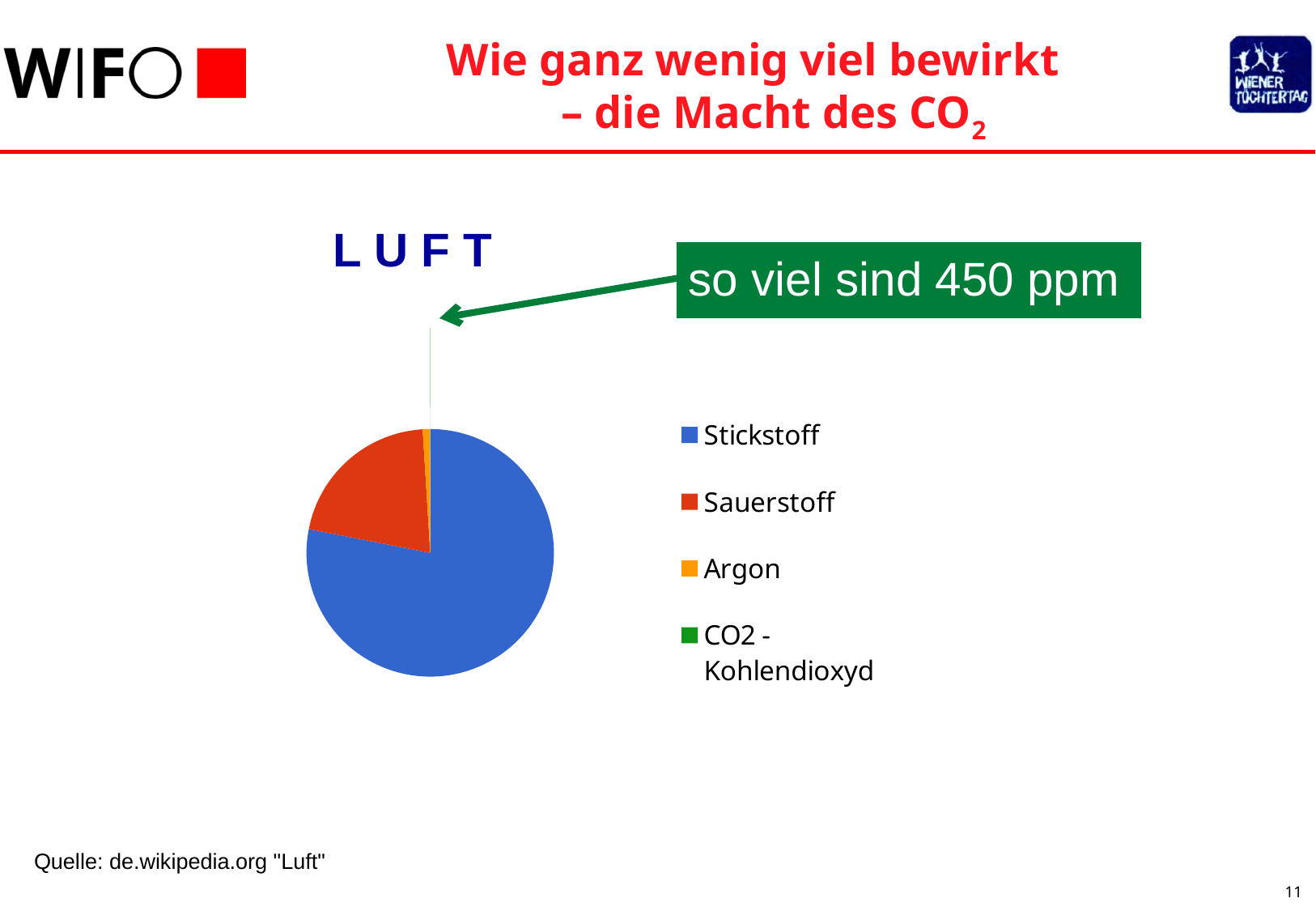
What kind of chart is shown on the slide? pie chart Which category has the largest slice of the pie chart? Stickstoff Which category has the smallest slice of the pie chart? CO2 - Kohlendioxyd Which slice is larger, Argon or Stickstoff? Stickstoff Which slice is larger, Sauerstoff or Argon? Sauerstoff Which category is listed last in the pie chart's legend? CO2 - Kohlendioxyd What colour is the Stickstoff slice in the pie chart? blue Which slice is larger, Stickstoff or Sauerstoff? Stickstoff What is the title of the pie chart? L U F T Which category is listed second in the pie chart's legend? Sauerstoff How many categories does the pie chart's legend list? 4